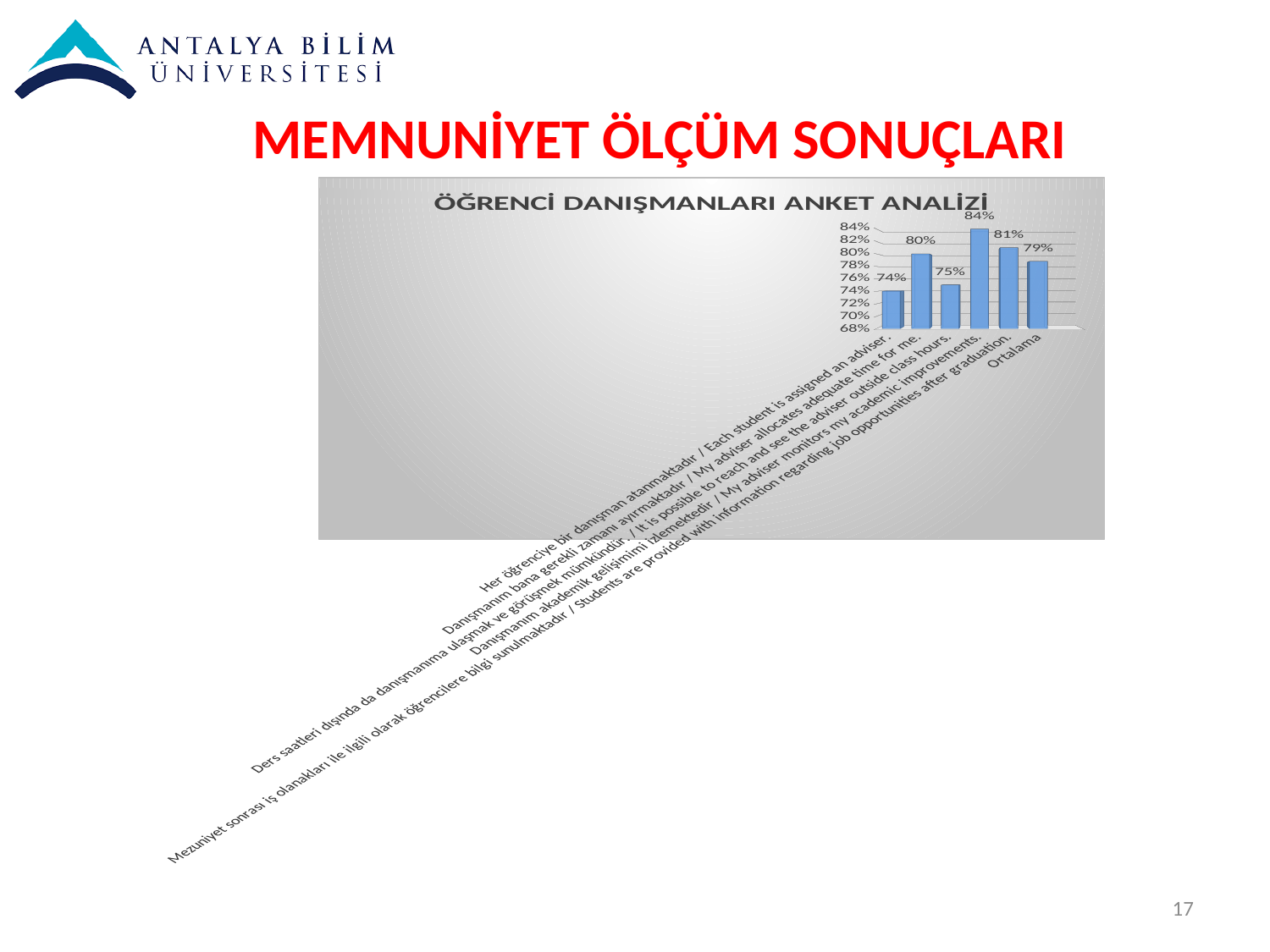
What is the title of the chart? ÖĞRENCİ DANIŞMANLARI ANKET ANALİZİ What is the value for "Each student is assigned an adviser"? 74% What is the value for "My adviser allocates adequate time for me"? 80% Which category has the highest value? Danışmanım akademik gelişimimi izlemektedir / My adviser monitors my academic improvements. Which category has the lowest value? Her öğrenciye bir danışman atanmaktadır / Each student is assigned an adviser. What is the value for "My adviser monitors my academic improvements"? 84% What is the lowest value shown on the vertical axis? 68% What is the difference between the highest value (84%) and the lowest value (74%)? 10% How many bars are plotted in the chart? 6 What kind of chart is shown on the slide? Bar chart Which is larger: the value for "It is possible to reach and see the adviser outside class hours" or the value for "Students are provided with information regarding job opportunities after graduation"? Students are provided with information regarding job opportunities after graduation What is the value for "Ortalama"? 79%